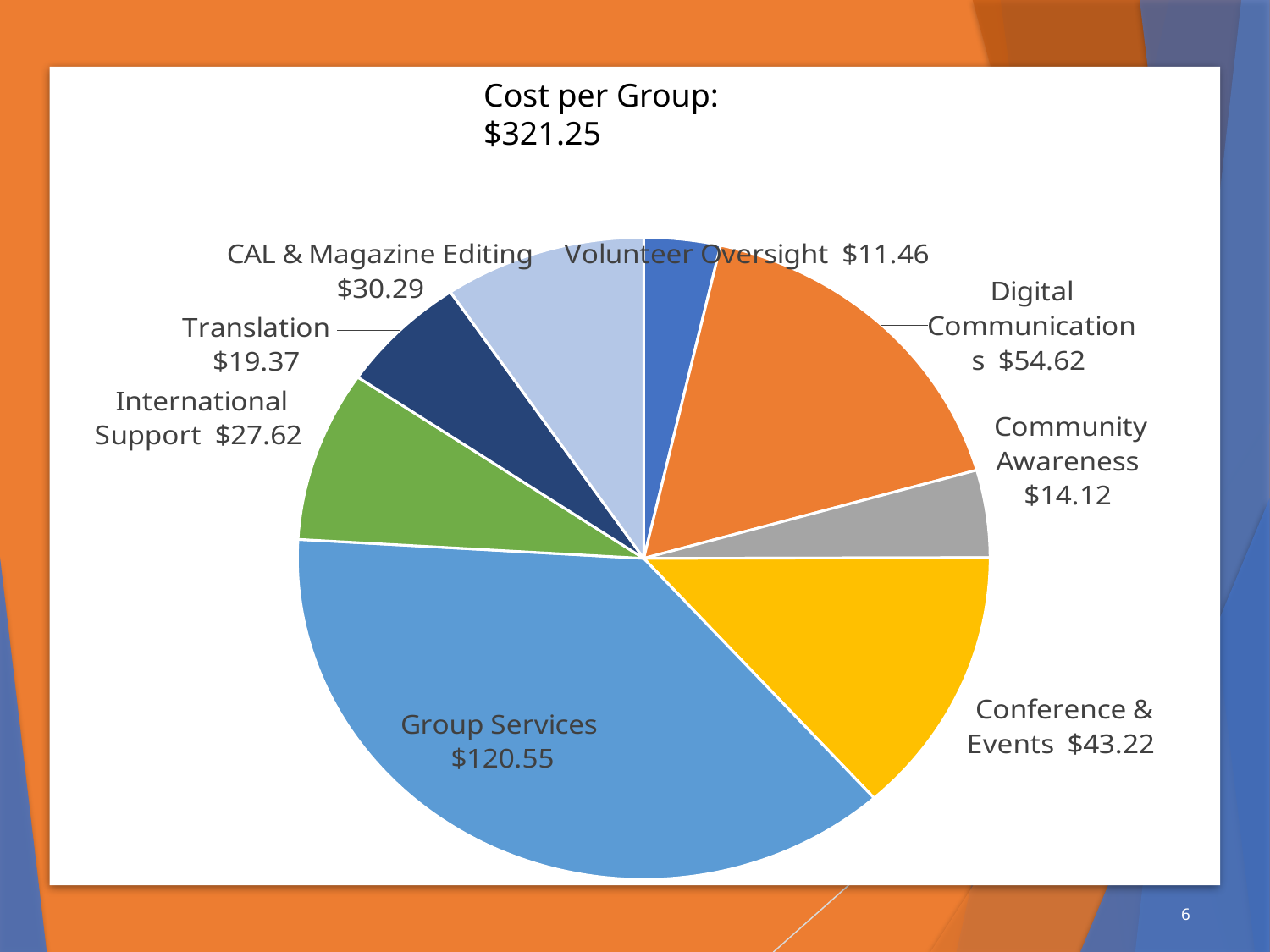
What is the difference between Group Services and Digital Communications? $65.93 What is the difference between Digital Communications and Conference & Events? $11.40 What colour is the Group Services slice? Blue Which is larger, International Support or CAL & Magazine Editing? CAL & Magazine Editing How many categories are shown in the pie chart? 8 What is the value shown for Digital Communications? $54.62 What kind of chart is shown on the slide? Pie chart What total cost per group is stated in the chart title? $321.25 Which category has the largest slice of the pie? Group Services What is the value shown for Translation? $19.37 Which category has the smallest slice of the pie? Volunteer Oversight What is the cost per group for Group Services? $120.55